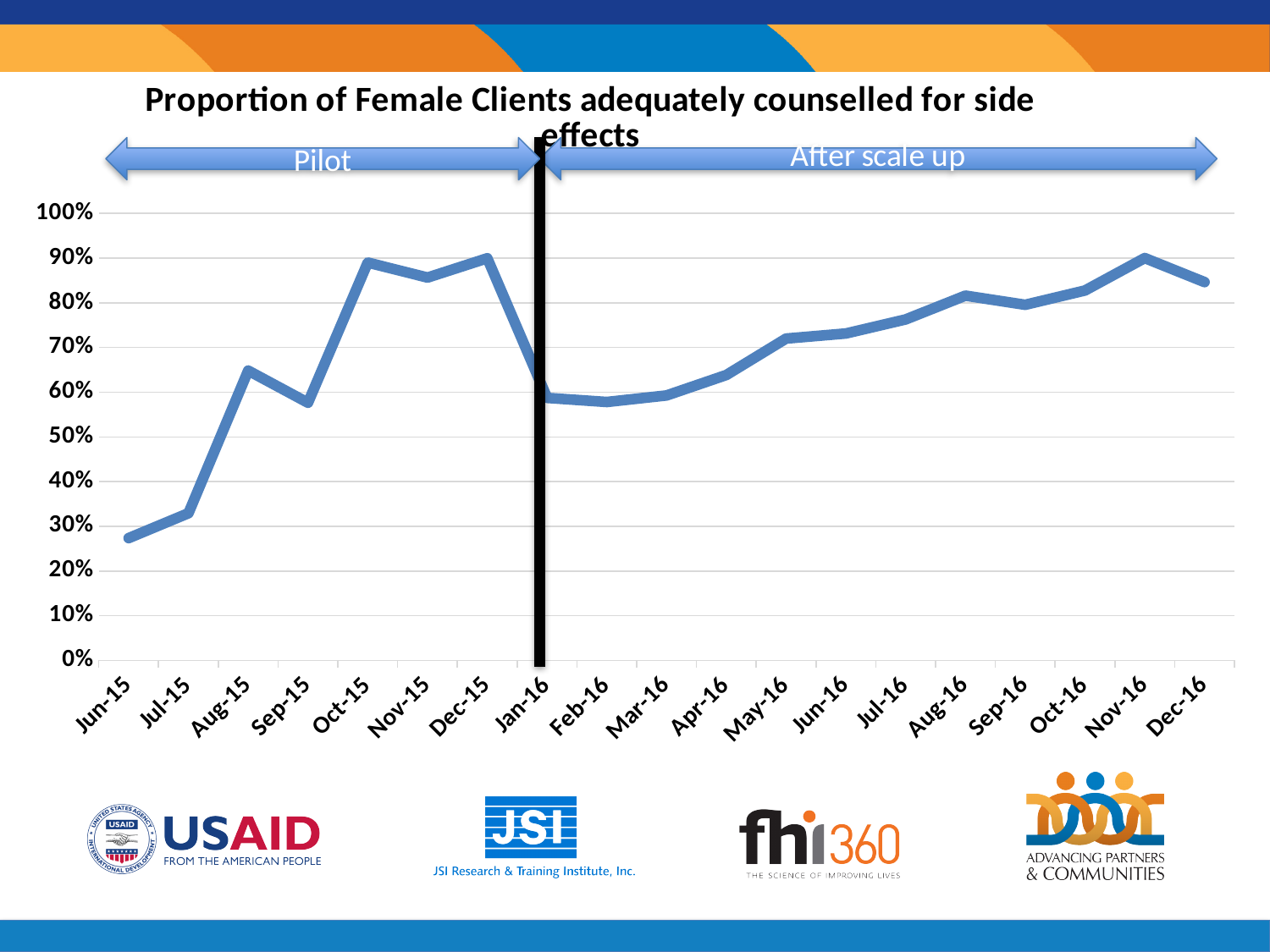
Is the value for Jun-15 greater or less than 30%? less Which is larger, the value for Apr-16 or the value for May-16? May-16 What are the two periods labelled by the arrows above the chart? Pilot and After scale up Which is larger, the value for Aug-15 or the value for Sep-15? Aug-15 What kind of chart is shown on the slide? line chart Is the value for Oct-15 greater or less than 80%? greater Do the values generally rise or fall from Feb-16 to Nov-16? rise Which month has the lowest proportion of female clients adequately counselled for side effects? Jun-15 What is the title of the chart? Proportion of Female Clients adequately counselled for side effects Is the value for Feb-16 greater or less than 60%? less How many months are plotted along the x axis? 19